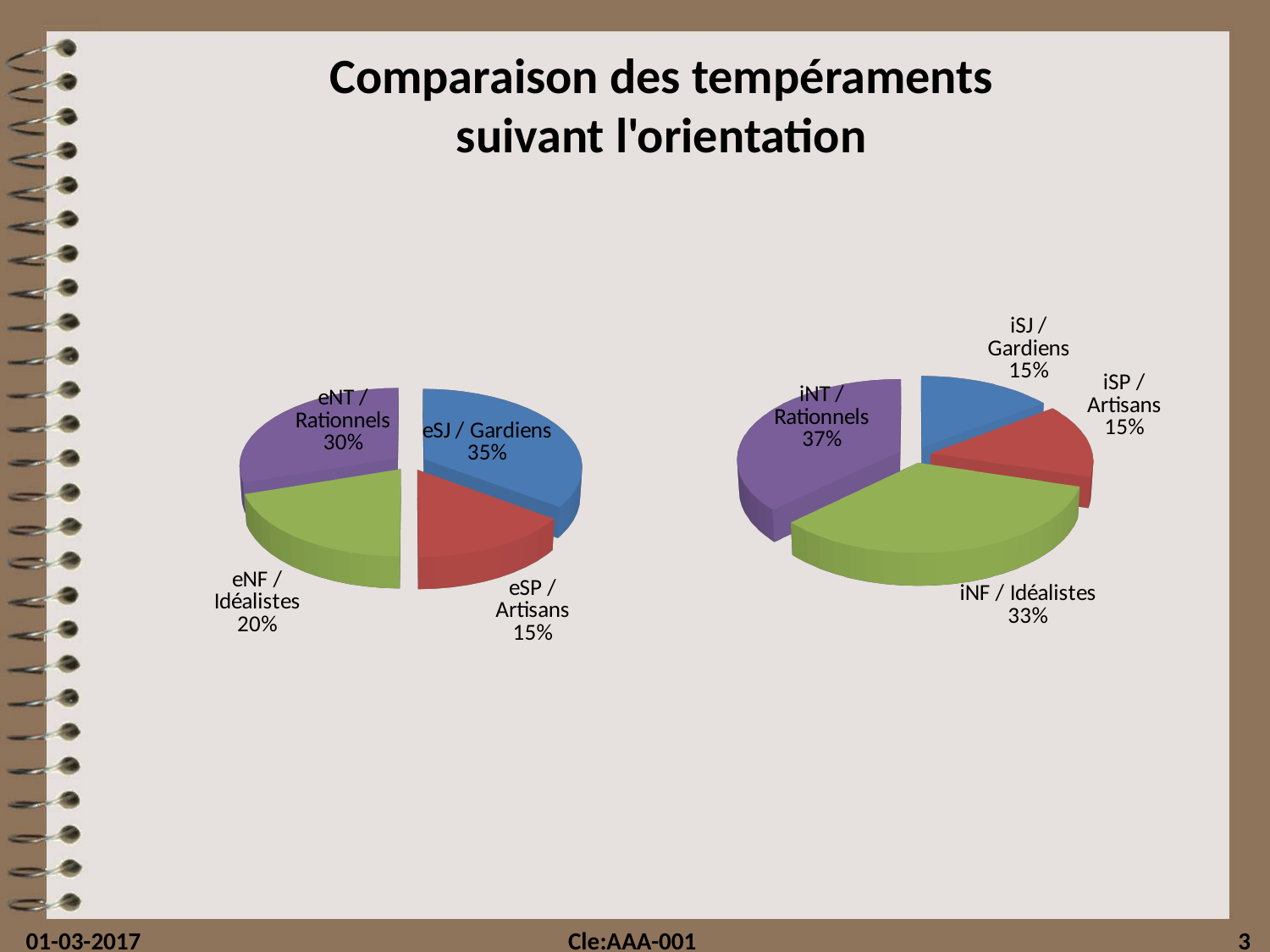
In the left pie chart, what is the share for eSJ / Gardiens? 35% In the left pie chart, what is the share for eNF / Idéalistes? 20% How many slices does the right pie chart have? 4 In the left pie chart, which category has the smallest slice? eSP / Artisans What type of chart is used on this slide? Pie chart In the right pie chart, what is the share for iNT / Rationnels? 37% In the right pie chart, what is the difference between the shares of iNT / Rationnels and iSJ / Gardiens? 22% In the right pie chart, what is the share for iNF / Idéalistes? 33% In the left pie chart, which category has the largest slice? eSJ / Gardiens In the right pie chart, which category has the largest slice? iNT / Rationnels In the left pie chart, what is the difference between the shares of eSJ / Gardiens and eNT / Rationnels? 5% In the left pie chart, which is larger: eNT / Rationnels or eNF / Idéalistes? eNT / Rationnels